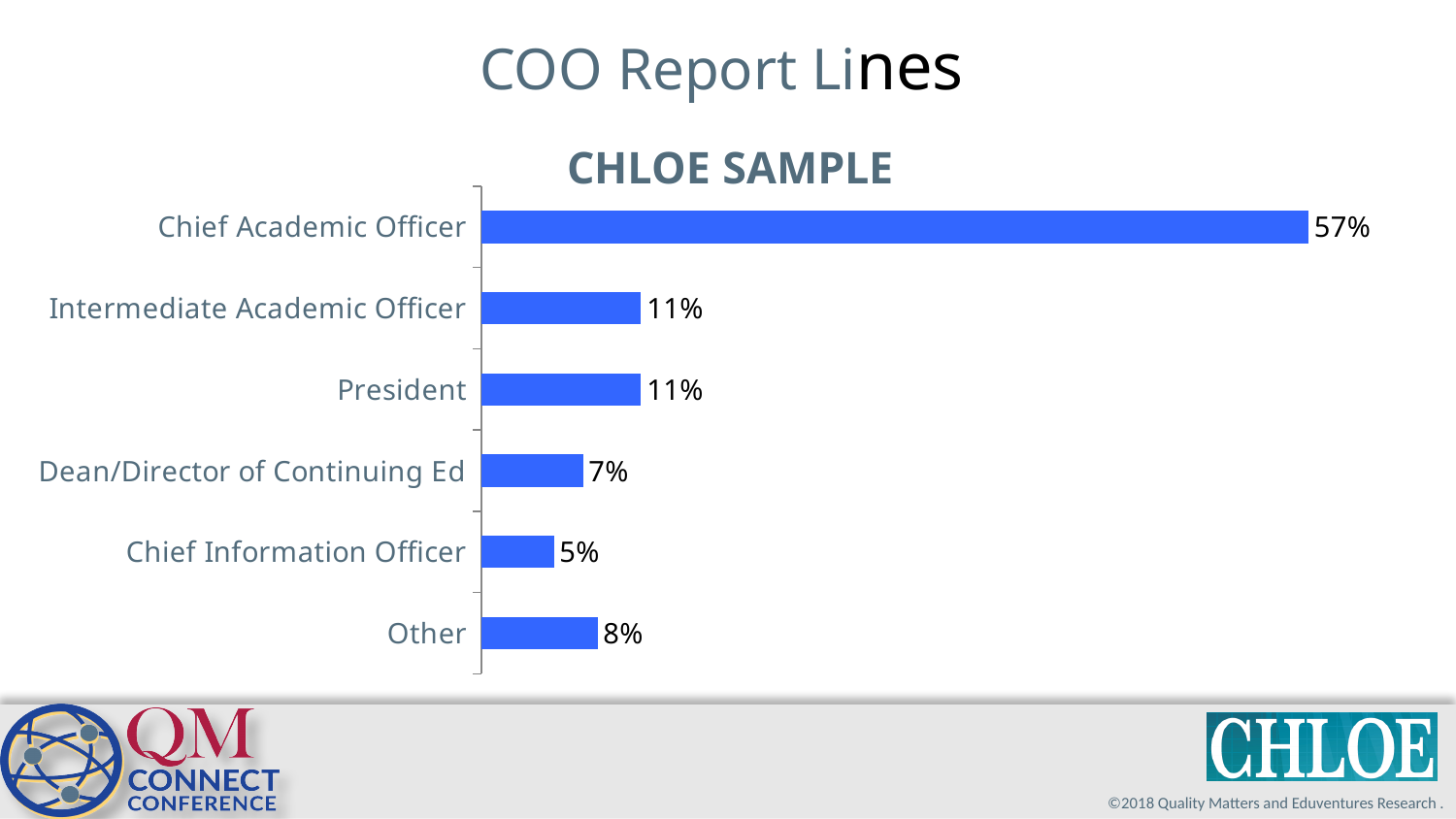
Which report line has the lowest percentage? Chief Information Officer Which is larger, the value for Other or the value for Dean/Director of Continuing Ed? Other What is the difference between the Chief Academic Officer and President values? 46% Which report line has the highest percentage? Chief Academic Officer What is the value for Dean/Director of Continuing Ed? 7% What is the value for Chief Information Officer? 5% What is the difference between the Other and Chief Information Officer values? 3% What is the value for Other? 8% What kind of chart is shown on the slide? Bar chart What is the title of the chart? CHLOE SAMPLE What percentage of COOs report to the Chief Academic Officer? 57% How many report line categories are shown in the chart? 6